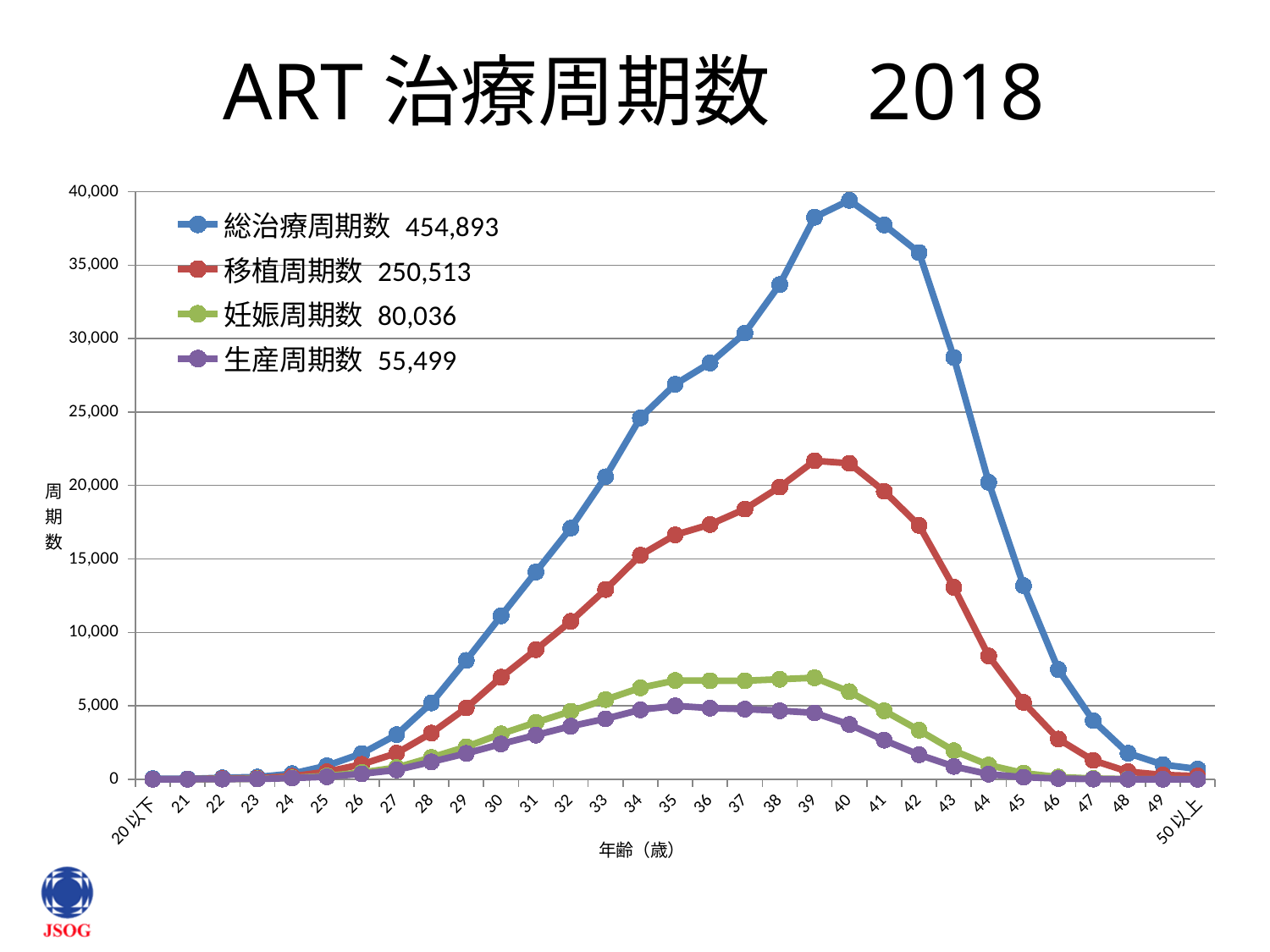
How many series does the legend list? 4 Do the 総治療周期数 values rise or fall between age 40 and age 45? fall What total is printed in the legend next to 移植周期数? 250,513 Is the value of 移植周期数 at age 39 greater or less than 20,000? greater What total is printed in the legend next to 妊娠周期数? 80,036 At which age does the 総治療周期数 series reach its highest value? 40 What total is printed in the legend next to 生産周期数? 55,499 What total is printed in the legend next to 総治療周期数? 454,893 How many age categories are plotted along the x axis? 31 Is the value of 総治療周期数 at age 40 greater or less than 35,000? greater What kind of chart is shown on the slide? line chart Which series has the higher value at age 35, 妊娠周期数 or 生産周期数? 妊娠周期数